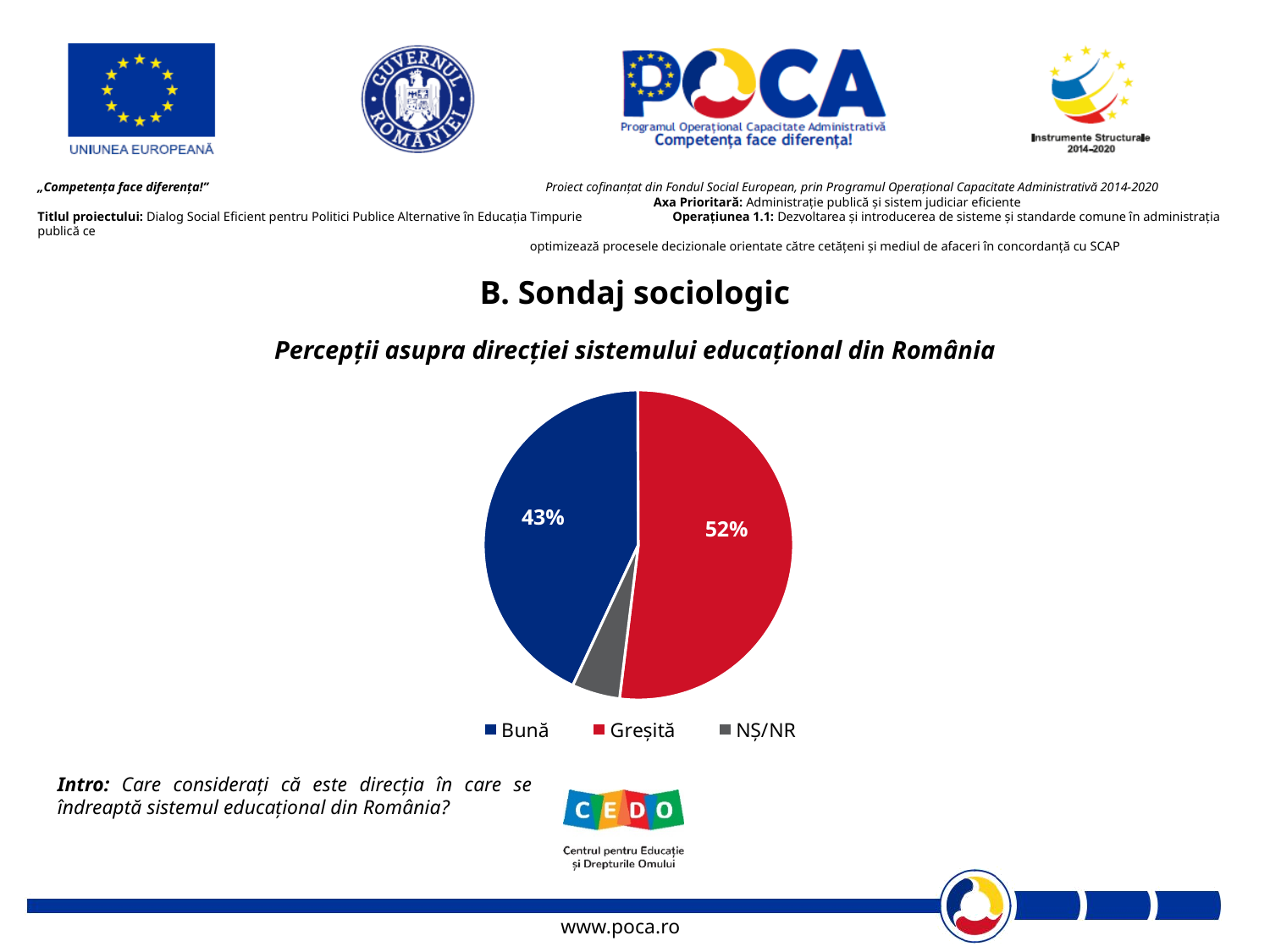
What colour is the "Bună" slice in the pie chart? Blue What percentage of respondents answered "Greșită" in the pie chart? 52% How many categories are shown in the pie chart? 3 By how many percentage points does "Greșită" exceed "Bună" in the pie chart? 9 percentage points Which category has the largest slice of the pie chart? Greșită Which category has the smallest slice of the pie chart? NȘ/NR How many entries does the legend of the chart list? 3 What is the title of the chart on the slide? Percepții asupra direcției sistemului educațional din România Which is larger in the pie chart, "Bună" or "Greșită"? Greșită What kind of chart is shown on the slide? Pie chart What percentage of respondents answered "Bună" in the pie chart? 43% Is the share for "Greșită" greater or less than 50%? greater